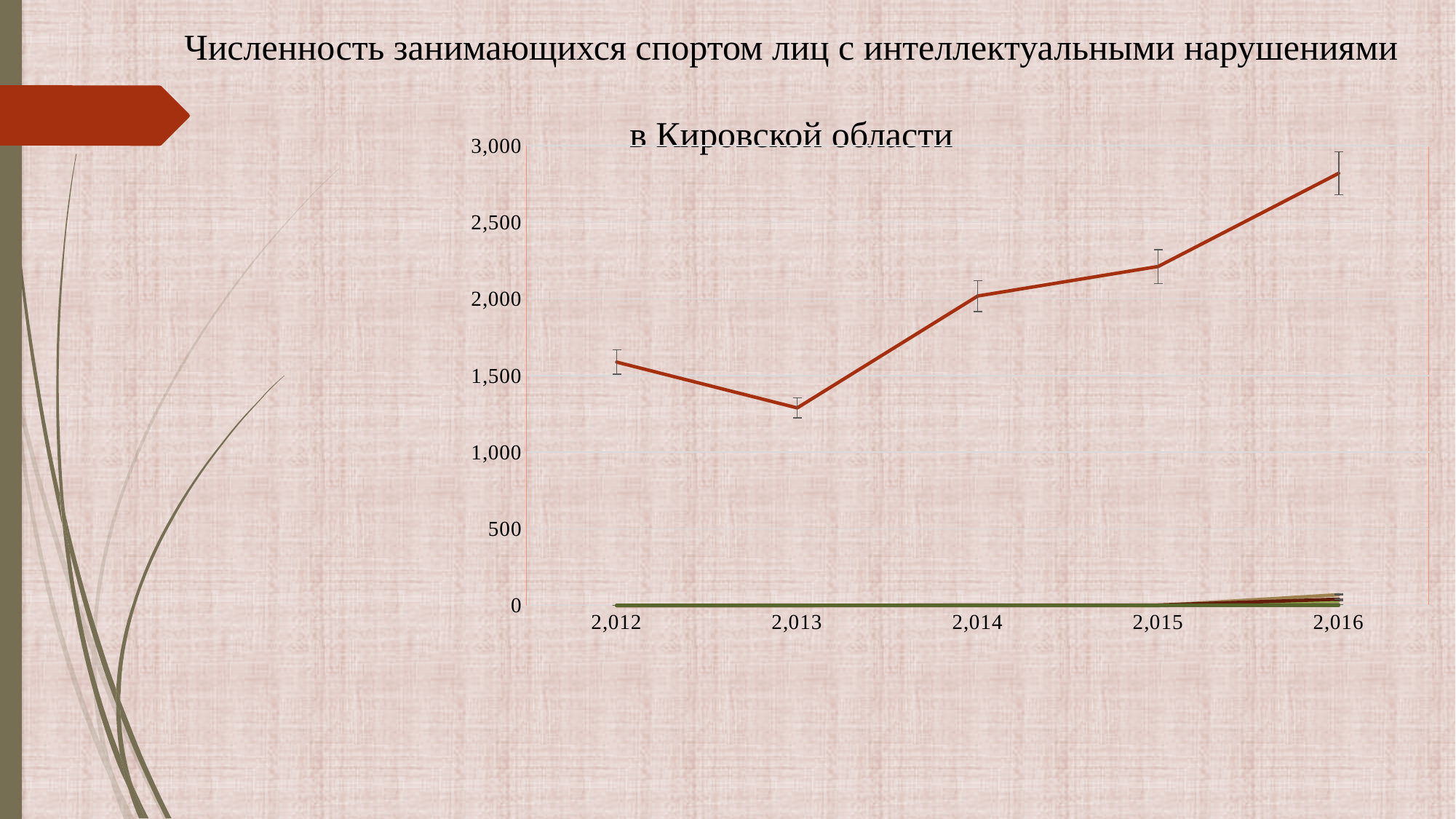
What kind of chart is shown on the slide? line chart Is the value of the red line for 2,012 greater or less than 2,000? less Is the value of the red line for 2,016 greater or less than 2,500? greater Is the value of the red line for 2,013 greater or less than 1,500? less Does the red line rise or fall between 2,012 and 2,013? fall How many years are plotted along the x axis? 5 In which year does the red line reach its lowest value? 2,013 Does the red line rise or fall between 2,013 and 2,016? rise What is the title of the chart? Численность занимающихся спортом лиц с интеллектуальными нарушениями в Кировской области In which year does the red line reach its highest value? 2,016 Which year has the larger value on the red line, 2,012 or 2,013? 2,012